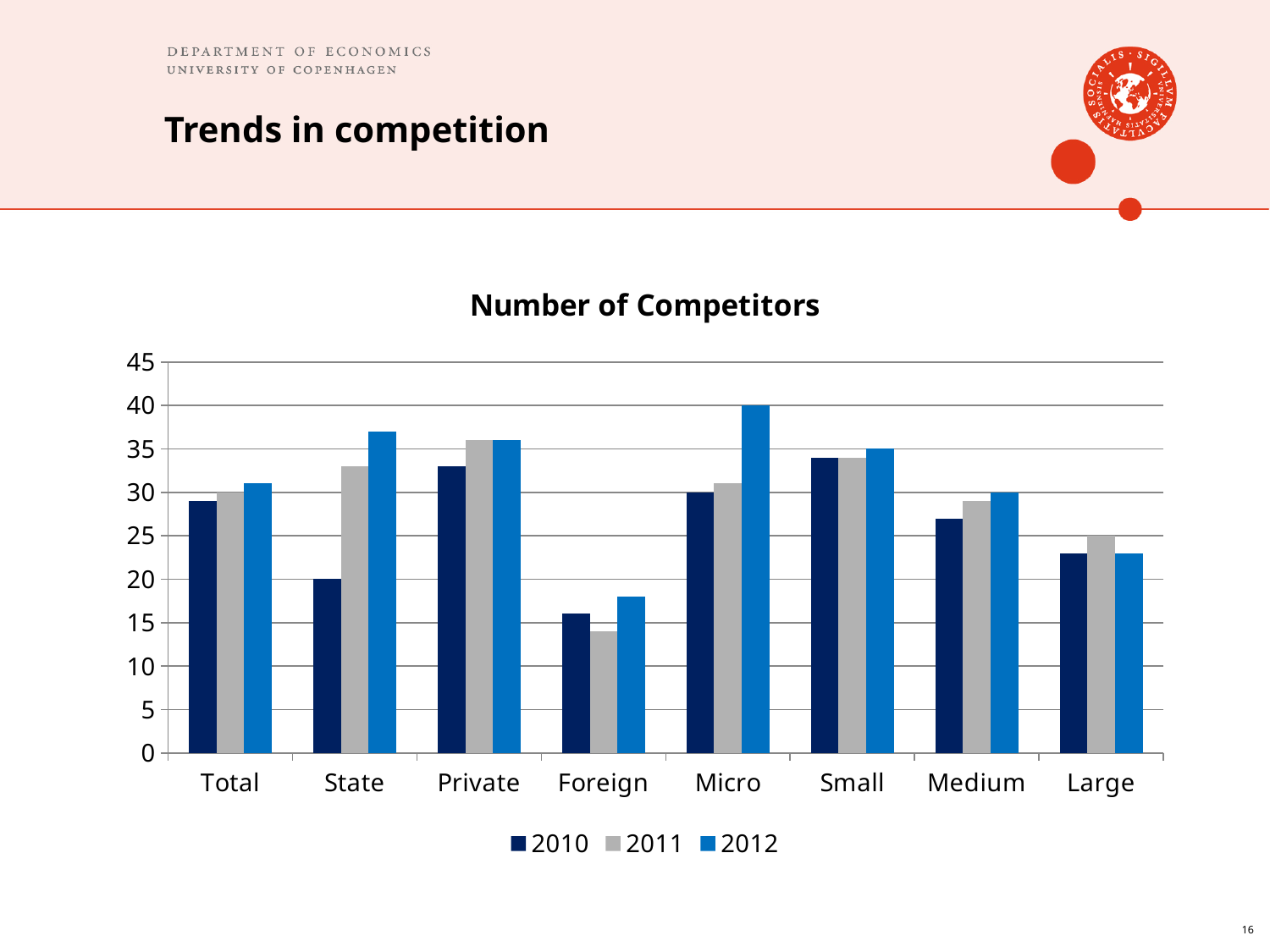
What is the value for State in 2010? 20 What is the value for Large in 2011? 25 How many categories are shown on the x axis? 8 Which category has the lowest values across all three years? Foreign What kind of chart is shown on the slide? bar chart How many series does the legend list? 3 Do the values for State rise or fall from 2010 to 2012? rise What is the title of the chart? Number of Competitors Which years are listed in the legend? 2010, 2011, 2012 Which category has the highest value in 2012? Micro What is the value for Micro in 2012? 40 Is the value for Foreign in 2011 greater or less than 15? less